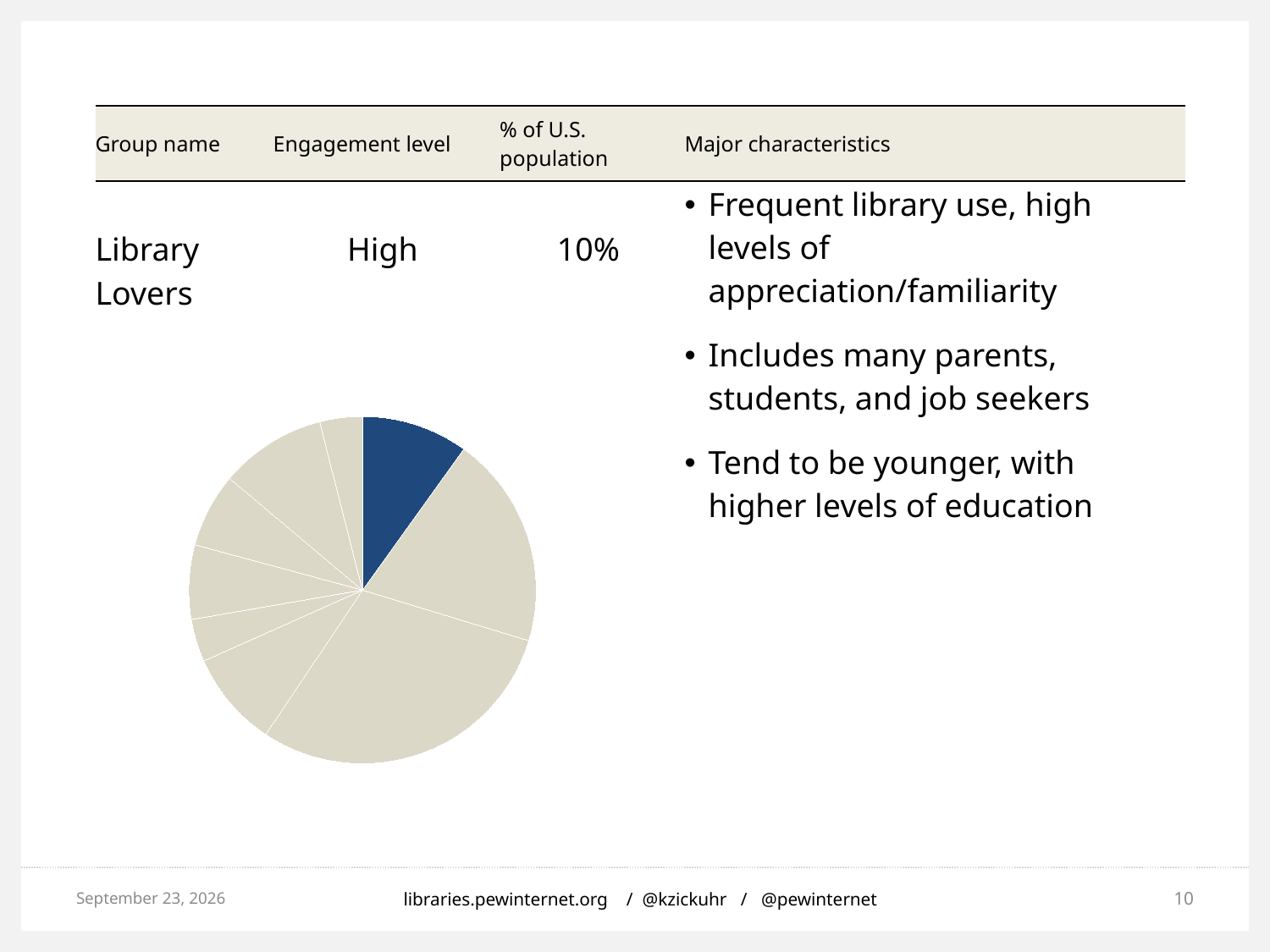
Does the pie chart display data labels on its slices? No Is the share of the highlighted blue slice greater or less than 25%? less What kind of chart is shown on the slide? pie chart Which group does the highlighted blue slice of the pie chart correspond to? Library Lovers Is the highlighted blue slice the largest slice in the pie chart? No What colour is the highlighted slice in the pie chart? blue What share of the U.S. population does the highlighted (blue) slice of the pie represent, according to the slide? 10% Is the highlighted blue slice larger or smaller than the large beige slice immediately clockwise from it? smaller